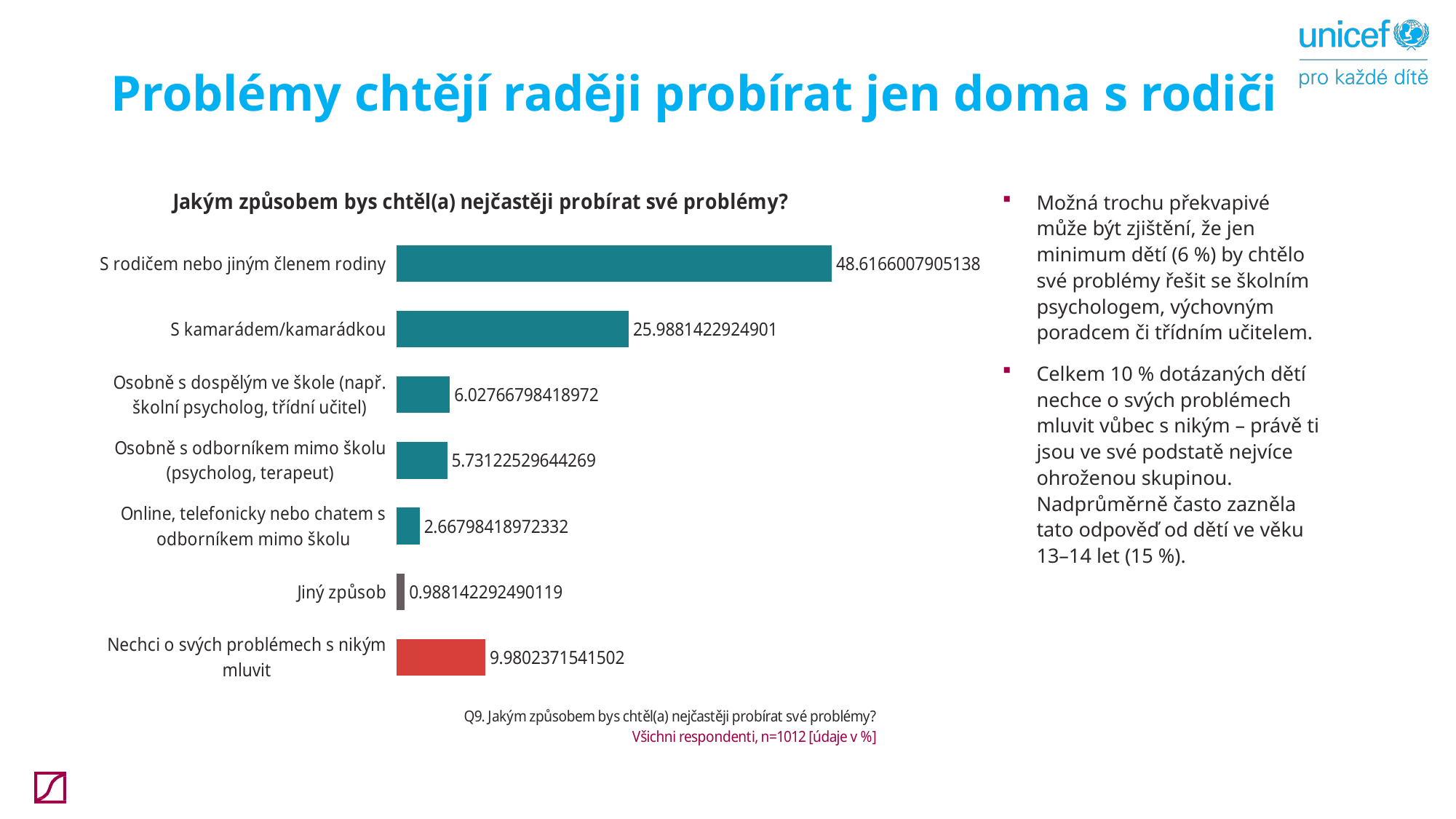
What is the value for "Online, telefonicky nebo chatem s odborníkem mimo školu"? 2.66798418972332 Which category's bar is coloured red? Nechci o svých problémech s nikým mluvit What is the difference between the values for "S rodičem nebo jiným členem rodiny" and "S kamarádem/kamarádkou"? 22.6284584980237 What is the value for "Jiný způsob"? 0.988142292490119 Which is larger: the value for "Osobně s dospělým ve škole (např. školní psycholog, třídní učitel)" or for "Osobně s odborníkem mimo školu (psycholog, terapeut)"? Osobně s dospělým ve škole (např. školní psycholog, třídní učitel) Which category has the highest value? S rodičem nebo jiným členem rodiny What is the value for "Nechci o svých problémech s nikým mluvit"? 9.9802371541502 What kind of chart is shown on the slide? Bar chart What is the value for "S kamarádem/kamarádkou"? 25.9881422924901 Which category has the lowest value? Jiný způsob What is the value for "S rodičem nebo jiným členem rodiny"? 48.6166007905138 How many categories are shown in the chart? 7